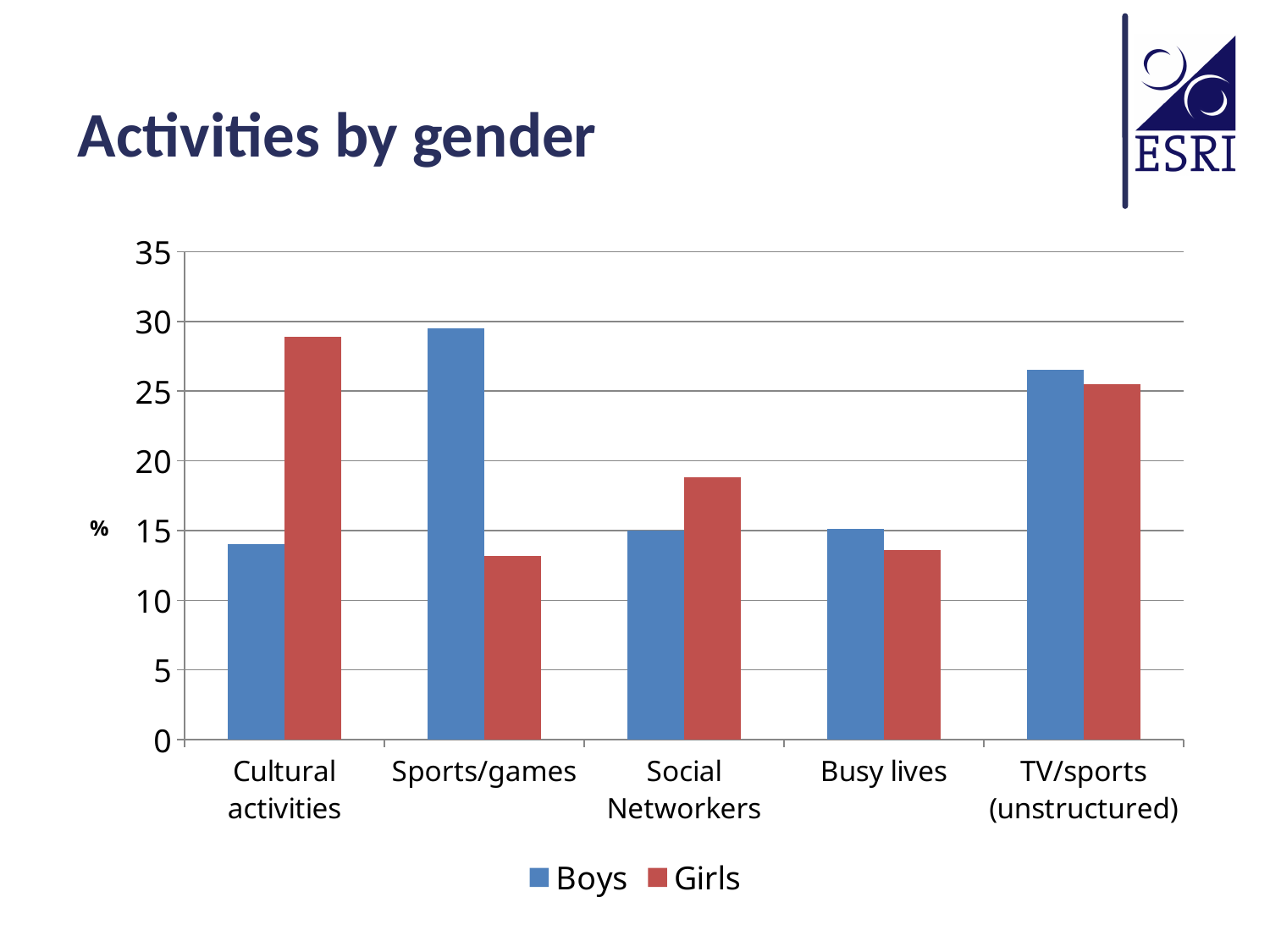
What is the title of the slide? Activities by gender Is the Girls value for Busy lives greater or less than 15? less What kind of chart is shown on the slide? bar chart Is the Boys value for Social Networkers greater or less than 20? less How many activity categories are shown on the x axis? 5 For which category is the Girls value highest? Cultural activities For Sports/games, which is larger, the Boys value or the Girls value? Boys Is the Girls value for Cultural activities greater or less than 25? greater For Social Networkers, which is larger, the Boys value or the Girls value? Girls How many series does the legend list? 2 For which category is the Boys value highest? Sports/games For Cultural activities, which is larger, the Boys value or the Girls value? Girls